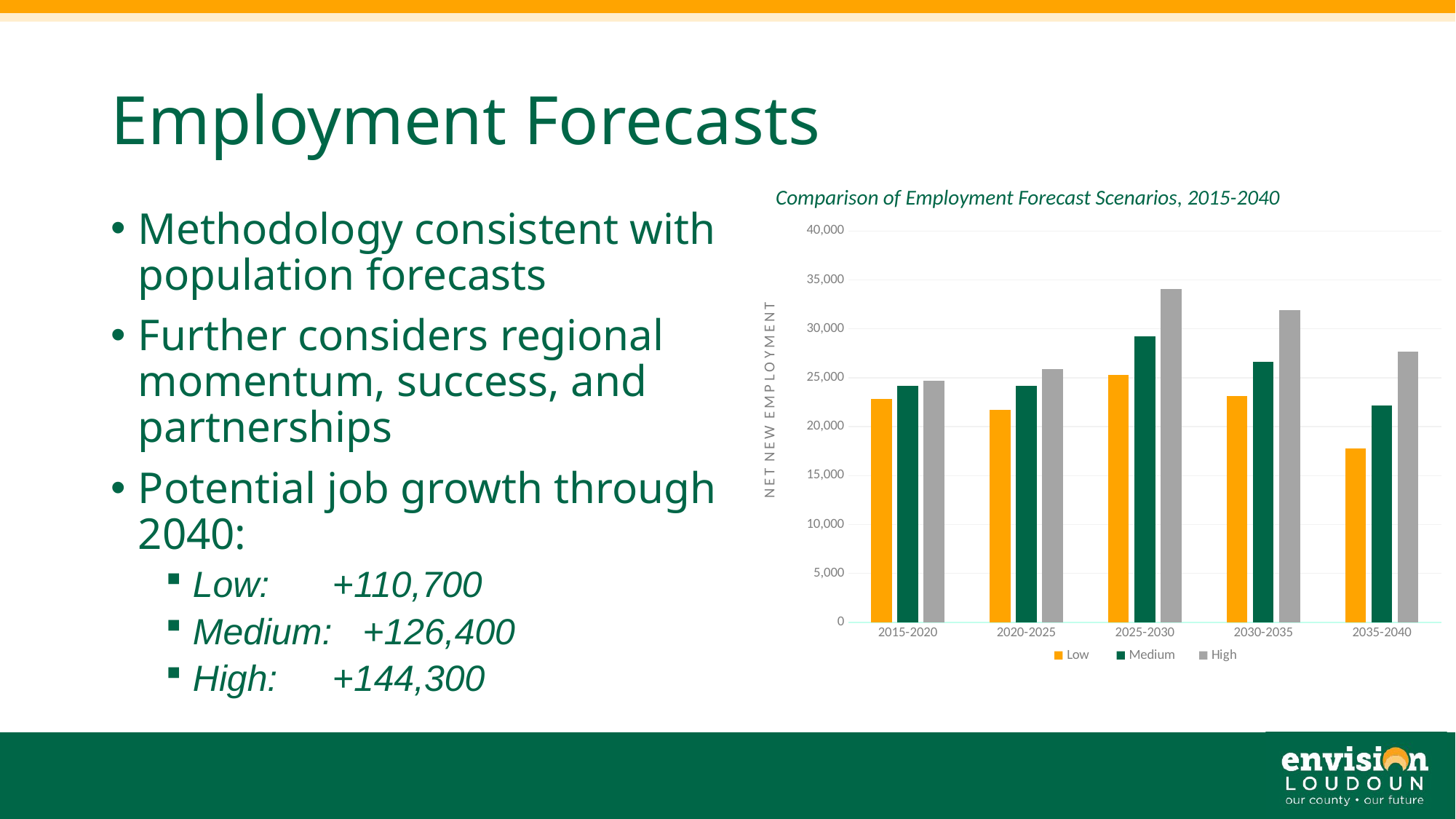
For 2030-2035, which scenario has the larger value, Medium or High? High In which period does the High scenario reach its highest value? 2025-2030 Is the High scenario value for 2025-2030 greater or less than 30,000? greater What is the title of the chart? Comparison of Employment Forecast Scenarios, 2015-2040 Does the High scenario rise or fall from 2025-2030 to 2035-2040? Fall For the Low scenario, which period has the larger value, 2015-2020 or 2020-2025? 2015-2020 Is the Medium scenario value for 2025-2030 greater or less than 25,000? greater What kind of chart is shown on the slide? Bar chart Is the Low scenario value for 2035-2040 greater or less than 20,000? less How many time periods are shown on the x axis of the chart? 5 In which period is the Low scenario value lowest? 2035-2040 How many series does the chart legend list? 3